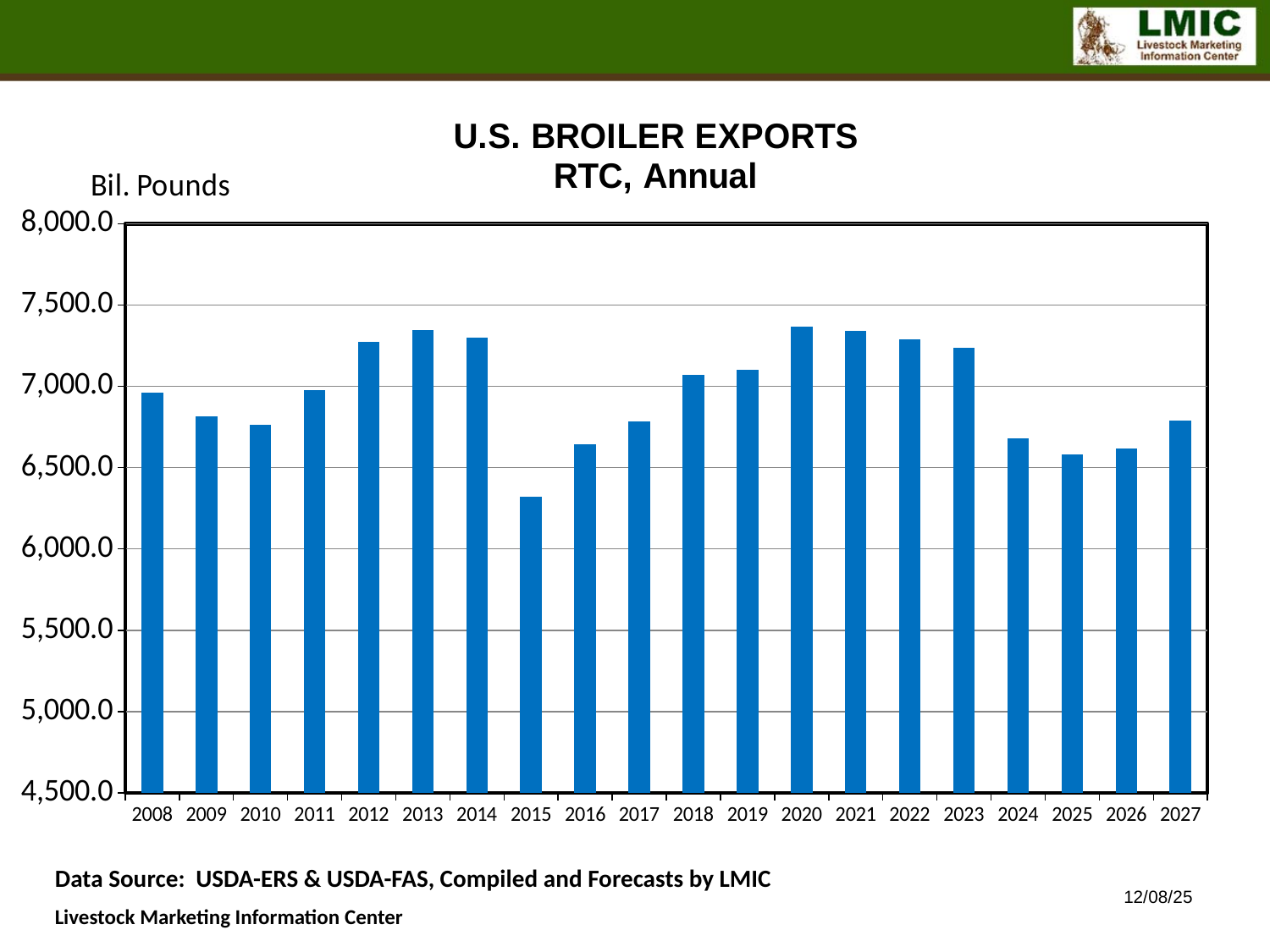
Do the values rise or fall from 2020 to 2025? fall What unit is shown on the vertical axis label? Bil. Pounds What kind of chart is shown on the slide? bar chart Is the value for 2012 greater or less than 7,000.0? greater How many years are plotted on the chart? 20 Is the value for 2020 greater or less than 7,500.0? less Is the value for 2008 greater or less than 7,000.0? less Which is larger, the value for 2015 or the value for 2016? 2016 Which year has the lowest value on the chart? 2015 Which is larger, the value for 2020 or the value for 2024? 2020